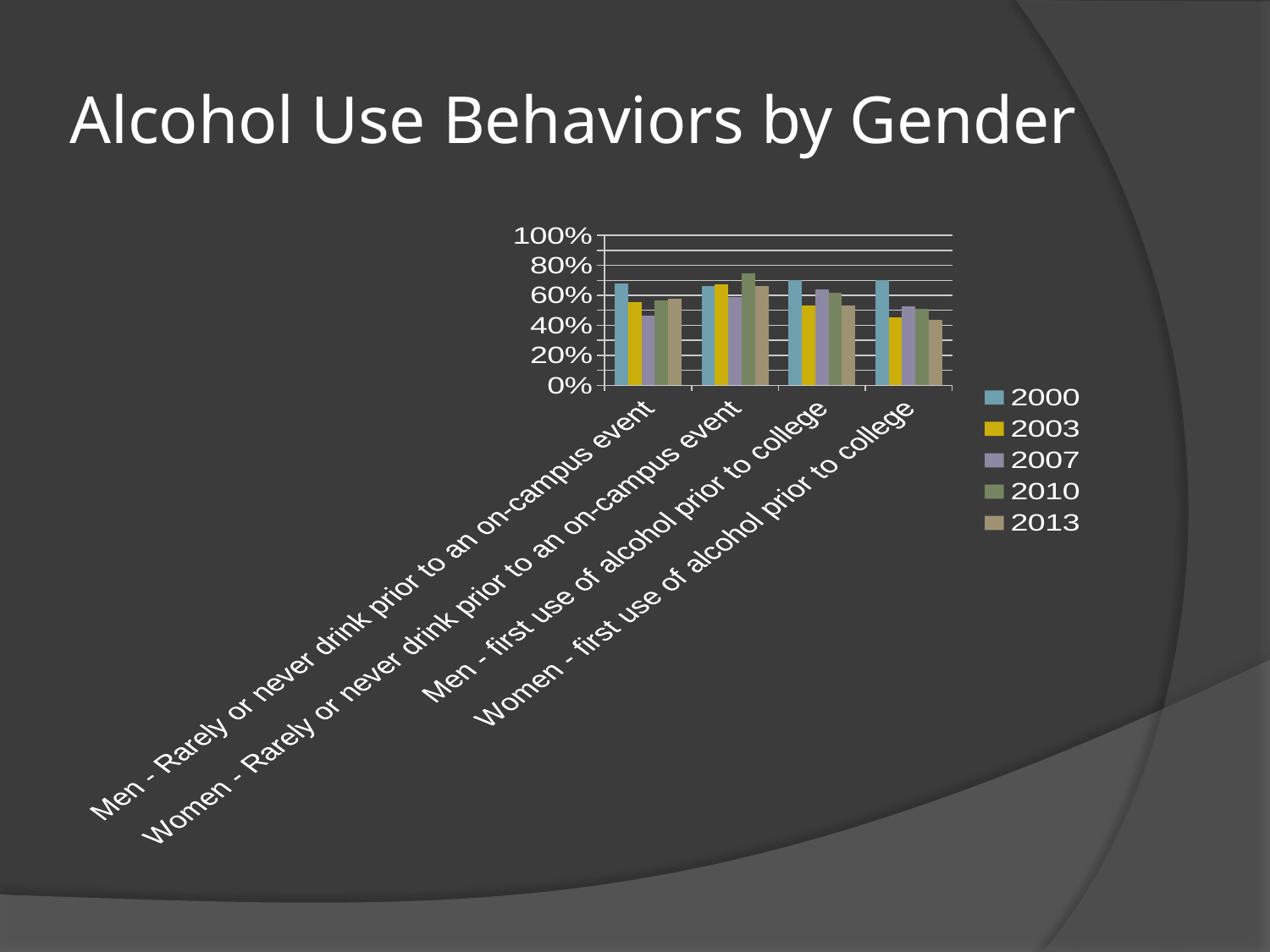
Is the 2013 value for 'Women - first use of alcohol prior to college' greater or less than 60%? less For 'Men - Rarely or never drink prior to an on-campus event', which year has the lowest bar? 2007 Is the 2007 value for 'Men - Rarely or never drink prior to an on-campus event' greater or less than 60%? less Is the 2010 value for 'Women - Rarely or never drink prior to an on-campus event' greater or less than 60%? greater For 'Men - first use of alcohol prior to college', is the 2000 bar or the 2003 bar taller? 2000 What kind of chart is shown on the slide? Bar chart How many categories are shown along the x axis of the chart? 4 How many series does the chart legend list? 5 What is the highest value shown on the chart's y axis? 100% For 'Women - Rarely or never drink prior to an on-campus event', which year has the highest bar? 2010 Which years are listed in the chart legend? 2000, 2003, 2007, 2010, 2013